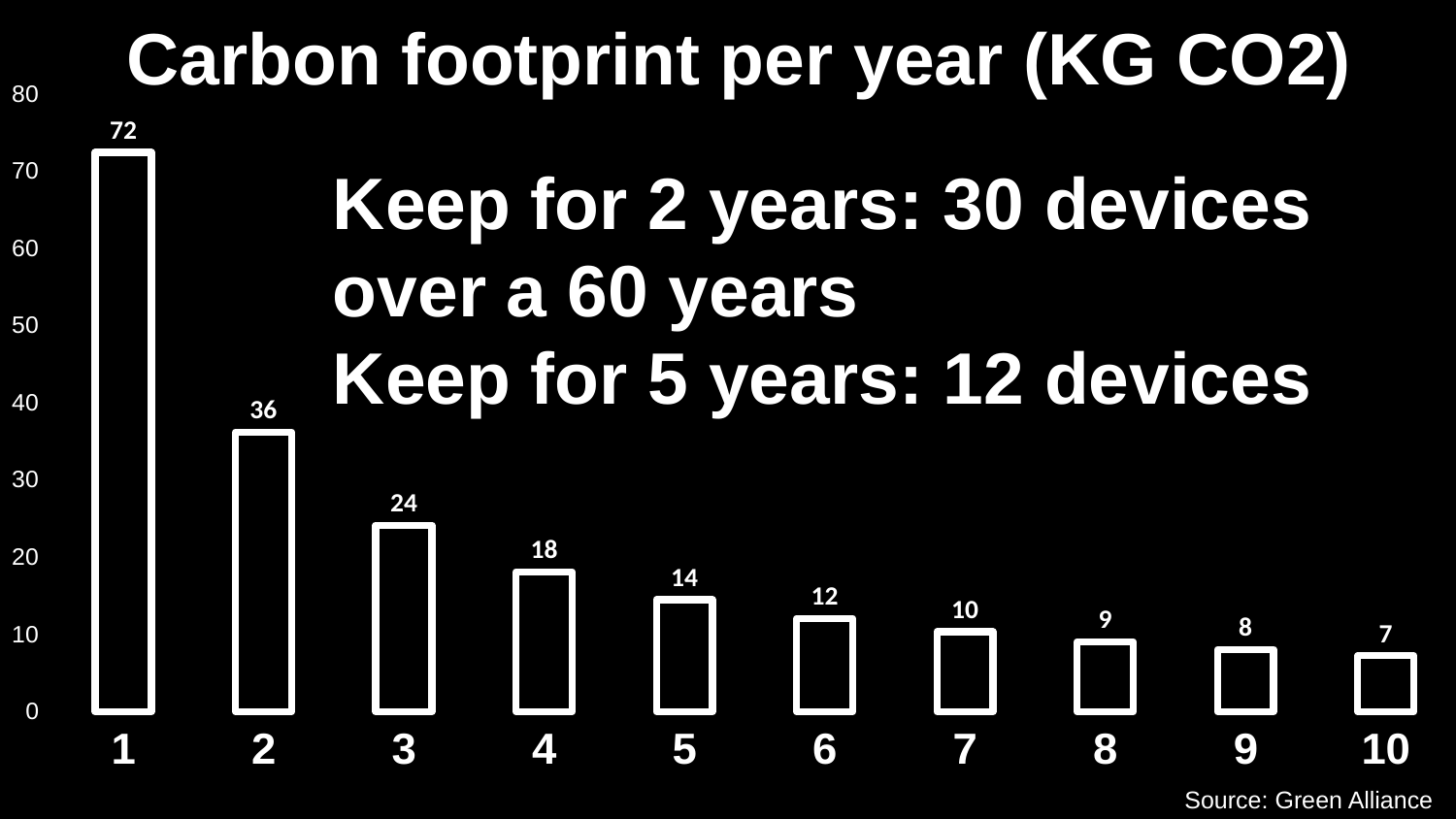
What is the value shown for category 4? 18 Which category has the highest carbon footprint per year? 1 What is the difference between the values for category 1 and category 2? 36 What is the carbon footprint per year value for category 1? 72 What is the value shown for category 10? 7 What is the difference between the values for category 3 and category 5? 10 Which is larger, the value for category 2 or the value for category 3? 2 How many categories are plotted on the chart? 10 Which category has the lowest carbon footprint per year? 10 What kind of chart is shown on the slide? bar chart Do the values rise or fall from category 1 to category 10? fall Is the value for category 6 greater or less than 10? greater